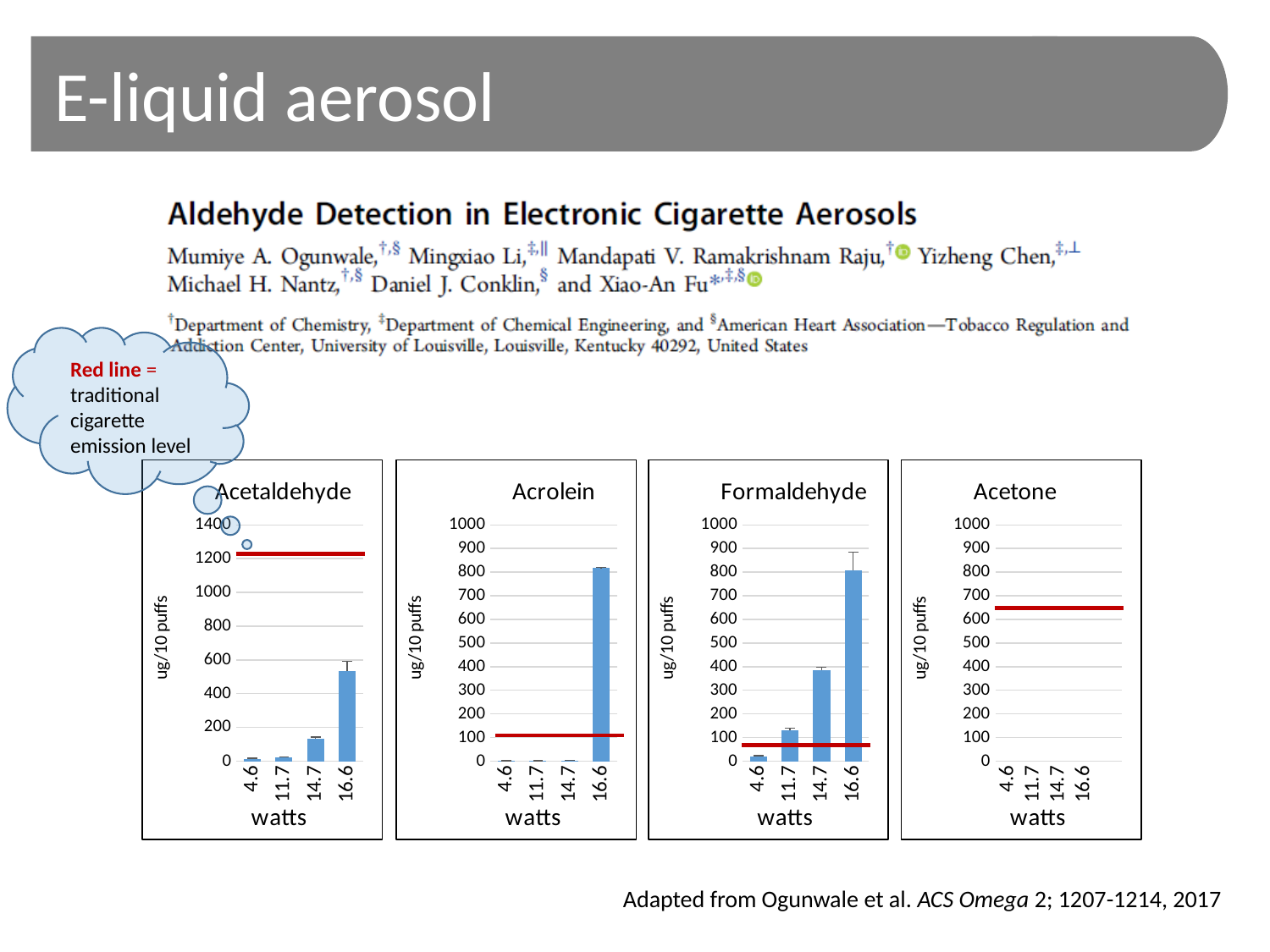
In the Formaldehyde chart, do the values rise or fall as wattage increases along the x axis? rise In the Acetaldehyde chart, is the value for 16.6 watts greater or less than 400? greater In the Acrolein chart, is the value for 16.6 watts greater or less than 700? greater In the Formaldehyde chart, is the value for 14.7 watts greater or less than 300? greater In the Formaldehyde chart, which wattage has the highest value? 16.6 In the Formaldehyde chart, which is larger, the value for 14.7 watts or the value for 16.6 watts? 16.6 watts What kind of chart is the Acetaldehyde chart? bar chart How many wattage categories are shown on the x axis of the Acrolein chart? 4 According to the slide, what does the red line on each chart represent? traditional cigarette emission level What is the y-axis label on the Acetone chart? ug/10 puffs In the Acetaldehyde chart, which wattage has the highest value? 16.6